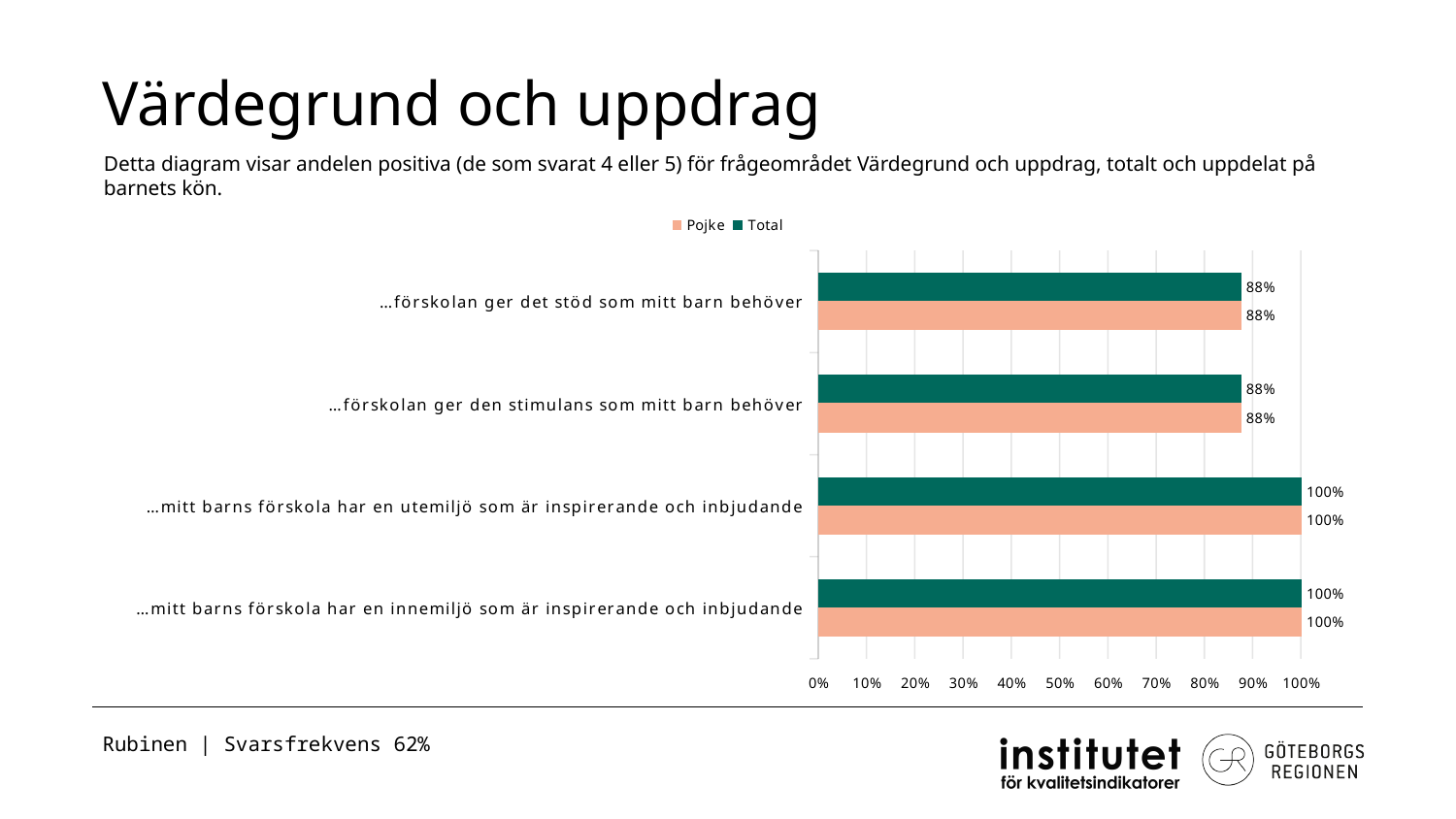
Which is larger: the Pojke value for "…mitt barns förskola har en innemiljö som är inspirerande och inbjudande" or the Pojke value for "…förskolan ger den stimulans som mitt barn behöver"? …mitt barns förskola har en innemiljö som är inspirerande och inbjudande What is the difference between the Total value for "…mitt barns förskola har en utemiljö som är inspirerande och inbjudande" and the Total value for "…förskolan ger det stöd som mitt barn behöver"? 12% How many categories are shown on the chart? 4 Which series is shown in green? Total What is the Pojke value for "…mitt barns förskola har en utemiljö som är inspirerande och inbjudande"? 100% What is the response rate (Svarsfrekvens) shown at the bottom of the slide? 62% How many series does the legend list? 2 What is the Total value for "…mitt barns förskola har en innemiljö som är inspirerande och inbjudande"? 100% What kind of chart is shown on the slide? Bar chart What is the Pojke value for "…förskolan ger den stimulans som mitt barn behöver"? 88% What is the Total value for "…förskolan ger det stöd som mitt barn behöver"? 88% Is the Total value for "…förskolan ger det stöd som mitt barn behöver" greater or less than 80%? greater